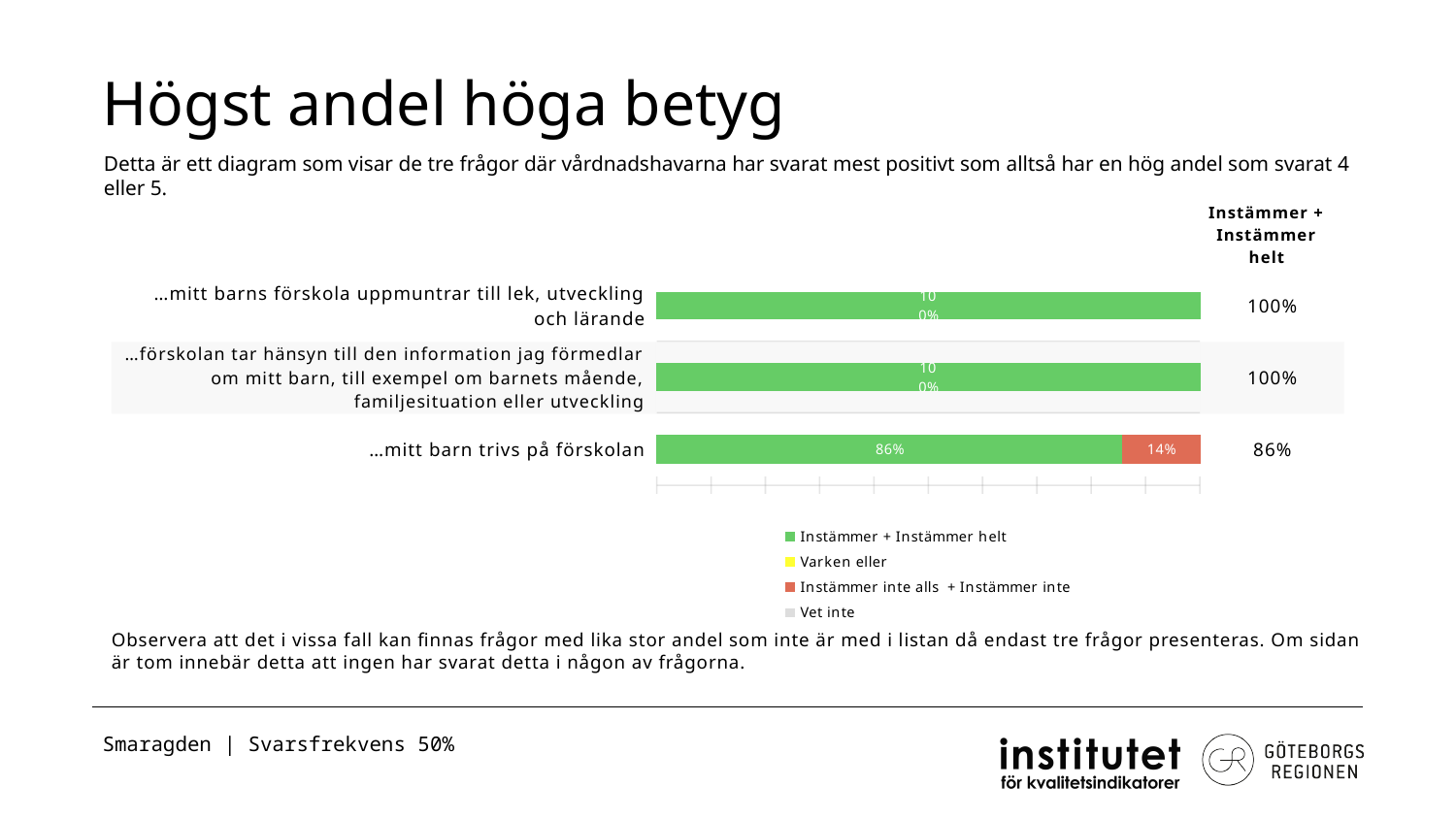
How many categories (questions) are plotted in the chart? 3 Which category has the lowest 'Instämmer + Instämmer helt' share? …mitt barn trivs på förskolan How many series does the legend list? 4 Which is larger: the 'Instämmer + Instämmer helt' share for '…mitt barn trivs på förskolan' or the 'Instämmer inte alls + Instämmer inte' share for the same question? Instämmer + Instämmer helt What is the total of the stacked bar for '…mitt barn trivs på förskolan'? 100% Which legend entry is shown in green? Instämmer + Instämmer helt What is the 'Instämmer + Instämmer helt' share for '…mitt barns förskola uppmuntrar till lek, utveckling och lärande'? 100% What share of responses for '…mitt barn trivs på förskolan' falls in 'Instämmer inte alls + Instämmer inte'? 14% What is the 'Instämmer + Instämmer helt' share for '…mitt barn trivs på förskolan'? 86% What is the difference in 'Instämmer + Instämmer helt' share between '…mitt barns förskola uppmuntrar till lek, utveckling och lärande' and '…mitt barn trivs på förskolan'? 14% What kind of chart is shown on the slide? bar chart What is the 'Instämmer + Instämmer helt' share for '…förskolan tar hänsyn till den information jag förmedlar om mitt barn, till exempel om barnets mående, familjesituation eller utveckling'? 100%